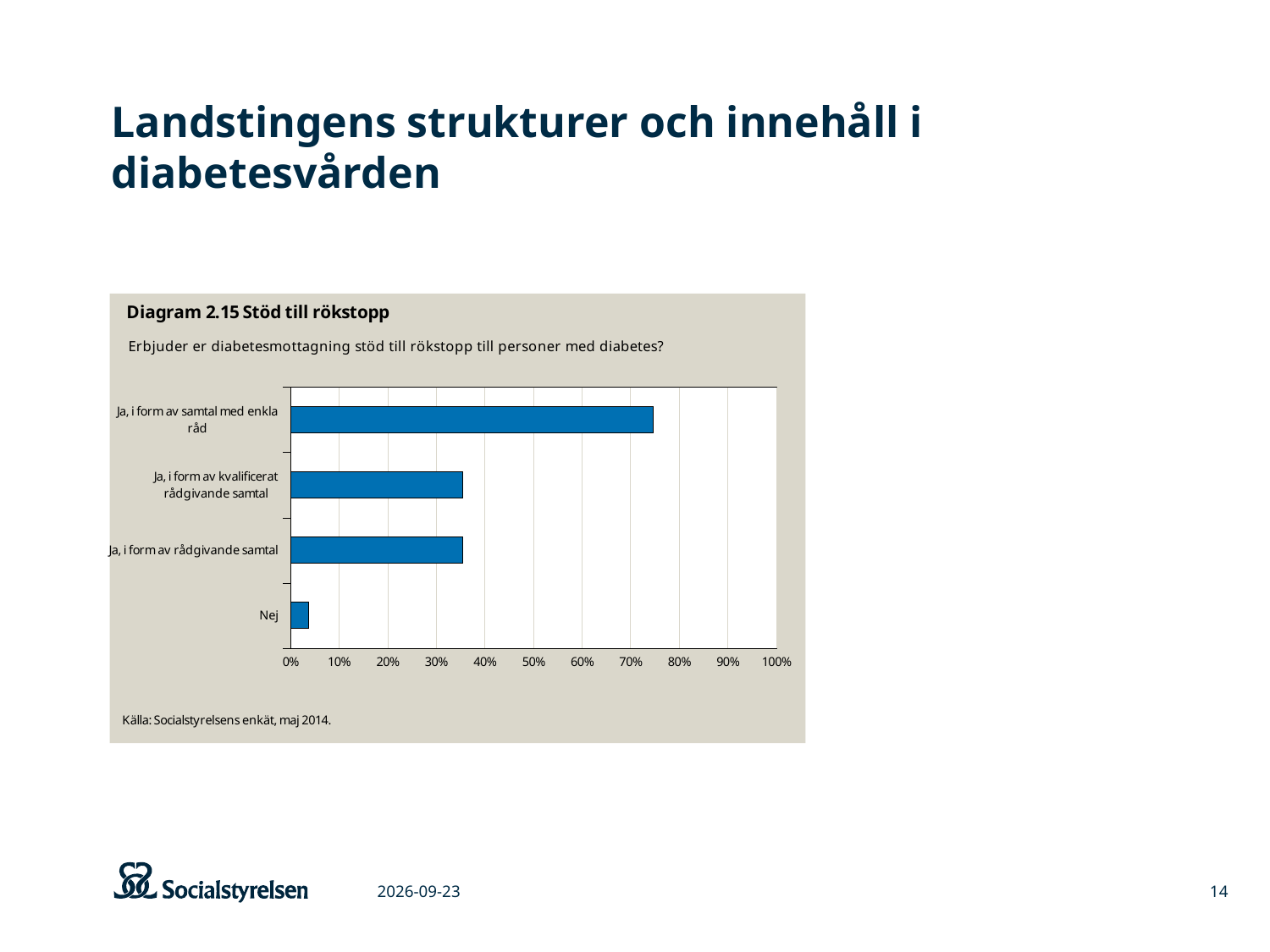
Which is larger: the value for "Ja, i form av samtal med enkla råd" or the value for "Ja, i form av rådgivande samtal"? Ja, i form av samtal med enkla råd What kind of chart is shown in Diagram 2.15 Stöd till rökstopp? bar chart How many categories (response options) are shown in the chart? 4 Is the value for "Nej" greater or less than 10%? less What source is given for the chart data? Socialstyrelsens enkät, maj 2014 Is the value for "Ja, i form av samtal med enkla råd" greater or less than 80%? less Which response option has the highest value in the chart? Ja, i form av samtal med enkla råd Is the value for "Ja, i form av kvalificerat rådgivande samtal" greater or less than 30%? greater What is the title of the diagram on the slide? Diagram 2.15 Stöd till rökstopp Which response option has the lowest value in the chart? Nej